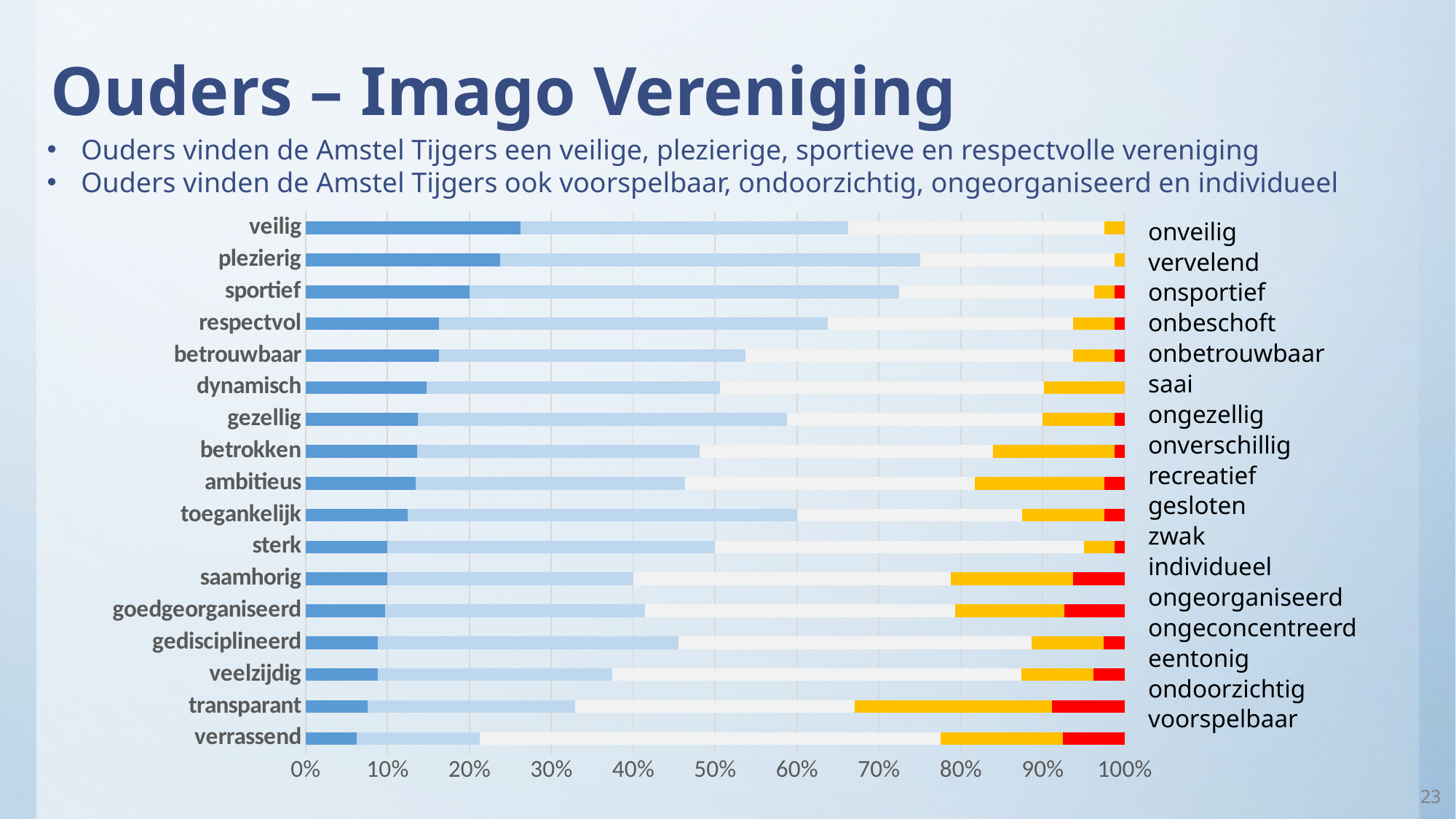
Is the dark blue segment for 'veilig' greater or less than 20%? greater Which category has the longest dark blue segment? veilig Which label appears on the right-hand side opposite the category 'veilig'? onveilig Going down the chart from 'veilig' to 'verrassend', does the dark blue segment generally get longer or shorter? shorter Does the combined dark blue and light blue portion for 'veelzijdig' end above or below 40%? below Is the dark blue segment for 'verrassend' greater or less than 10%? less What kind of chart is shown on the slide? bar chart How many categories (rows) are plotted in the chart? 17 What is the title of the slide containing the chart? Ouders – Imago Vereniging Which has the longer dark blue segment, 'veilig' or 'sportief'? veilig